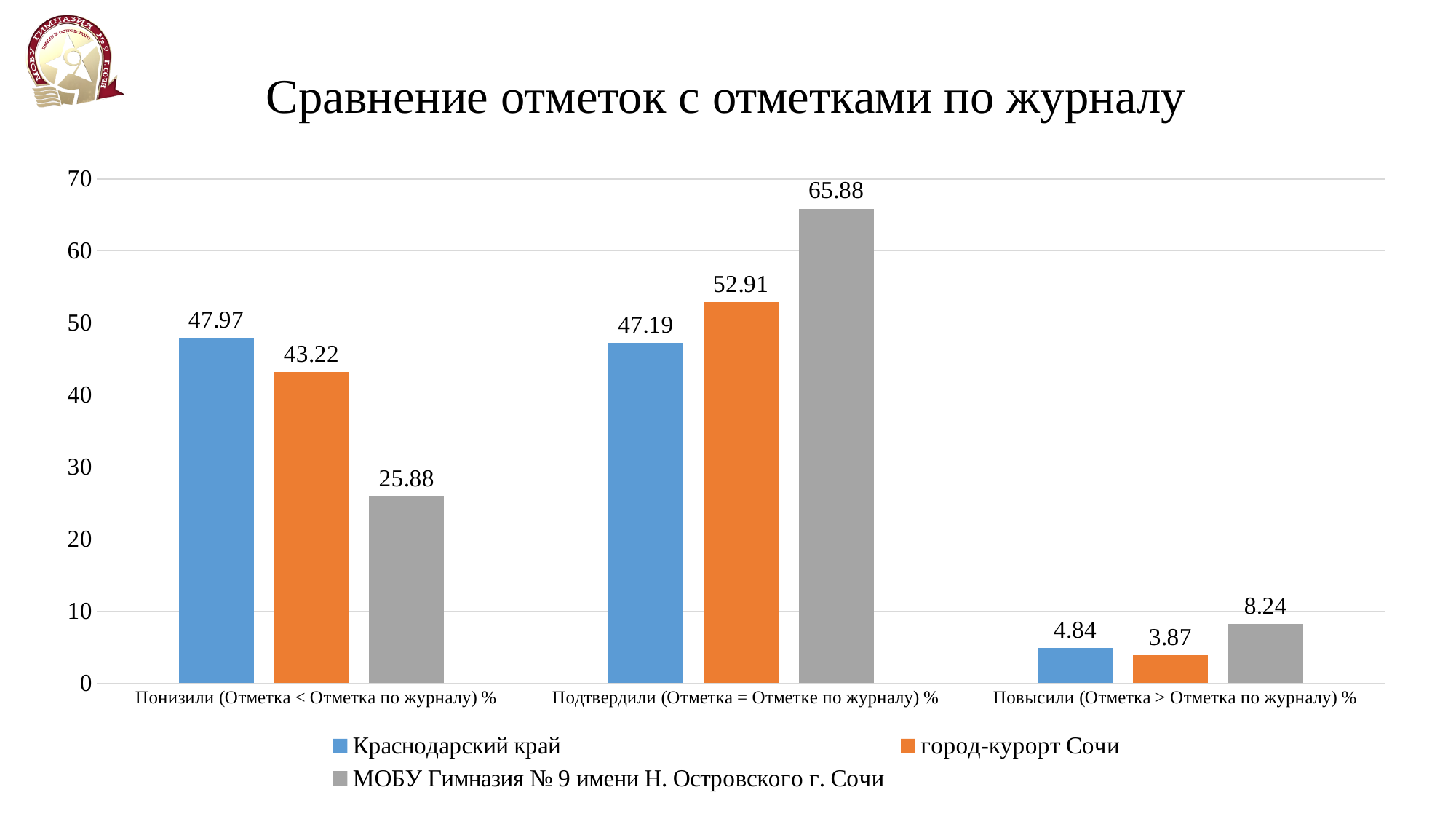
What is the value for МОБУ Гимназия № 9 имени Н. Островского г. Сочи in the Подтвердили (Отметка = Отметке по журналу) % category? 65.88 How many series does the legend list? 3 Is the value for город-курорт Сочи in the Понизили (Отметка < Отметка по журналу) % category greater or less than 40? greater Which series has the highest value in the Подтвердили (Отметка = Отметке по журналу) % category? МОБУ Гимназия № 9 имени Н. Островского г. Сочи Which series has the lowest value in the Понизили (Отметка < Отметка по журналу) % category? МОБУ Гимназия № 9 имени Н. Островского г. Сочи What is the value for город-курорт Сочи in the Повысили (Отметка > Отметка по журналу) % category? 3.87 What kind of chart is shown on the slide? bar chart In the Повысили (Отметка > Отметка по журналу) % category, which is larger: Краснодарский край or МОБУ Гимназия № 9 имени Н. Островского г. Сочи? МОБУ Гимназия № 9 имени Н. Островского г. Сочи What is the title of the chart? Сравнение отметок с отметками по журналу What is the difference between the город-курорт Сочи and Краснодарский край values in the Подтвердили (Отметка = Отметке по журналу) % category? 5.72 How many categories are shown on the x axis? 3 What is the value for Краснодарский край in the Понизили (Отметка < Отметка по журналу) % category? 47.97